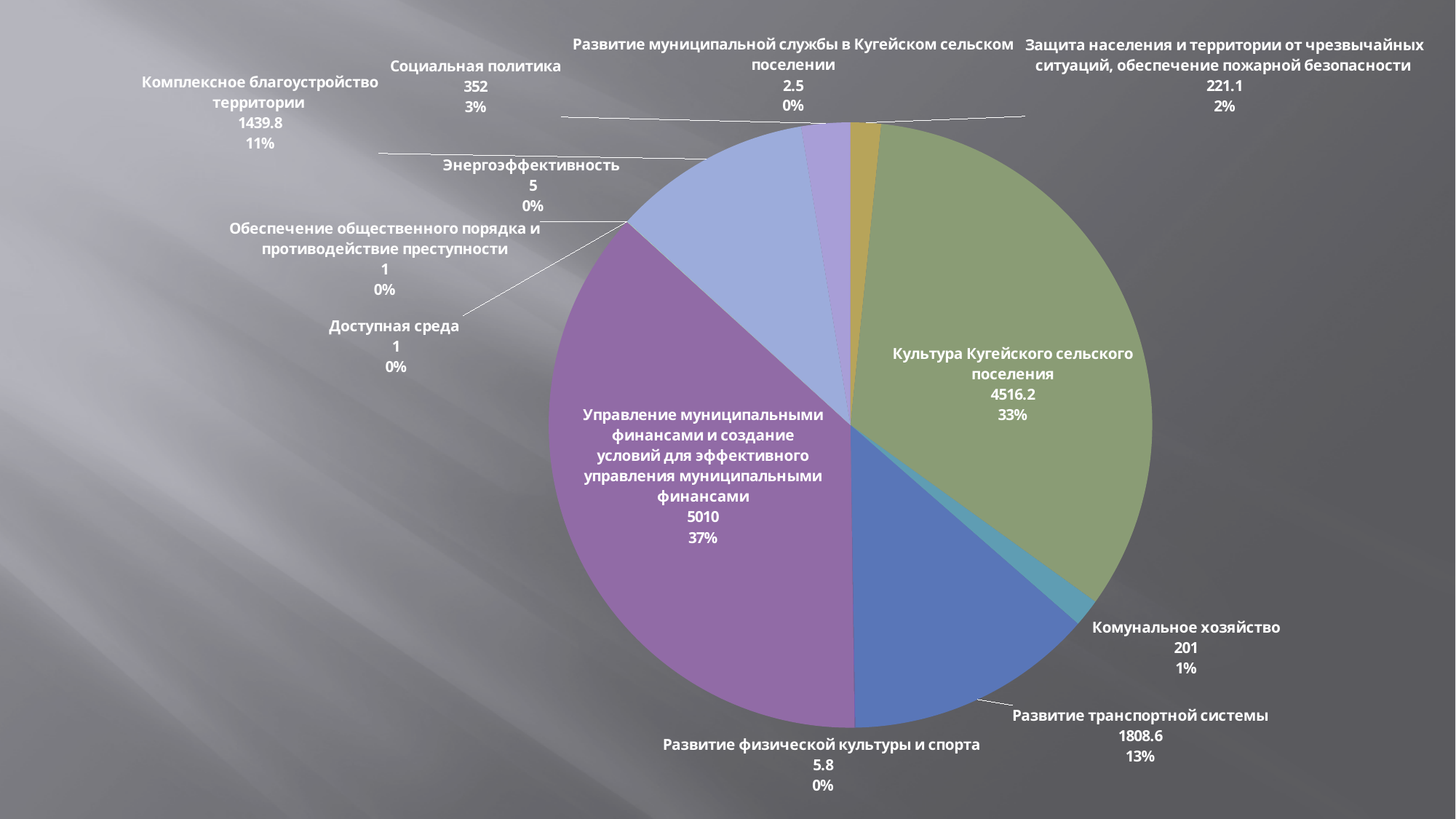
Which category has the largest slice of the pie? Управление муниципальными финансами и создание условий для эффективного управления муниципальными финансами What is the difference between the values for Комплексное благоустройство территории and Социальная политика? 1087.8 Which is larger, the value for Защита населения и территории от чрезвычайных ситуаций, обеспечение пожарной безопасности or the value for Коммунальное хозяйство? Защита населения и территории от чрезвычайных ситуаций, обеспечение пожарной безопасности What kind of chart is shown on the slide? pie chart What share of the pie does Развитие транспортной системы represent? 13% What is the value for Комплексное благоустройство территории? 1439.8 How many slices does the pie chart have? 12 What share of the pie does Культура Кугейского сельского поселения represent? 33% What is the value for Социальная политика? 352 What is the value for Развитие транспортной системы? 1808.6 What is the difference between the values for Управление муниципальными финансами и создание условий для эффективного управления муниципальными финансами and Культура Кугейского сельского поселения? 493.8 What is the value for Культура Кугейского сельского поселения? 4516.2